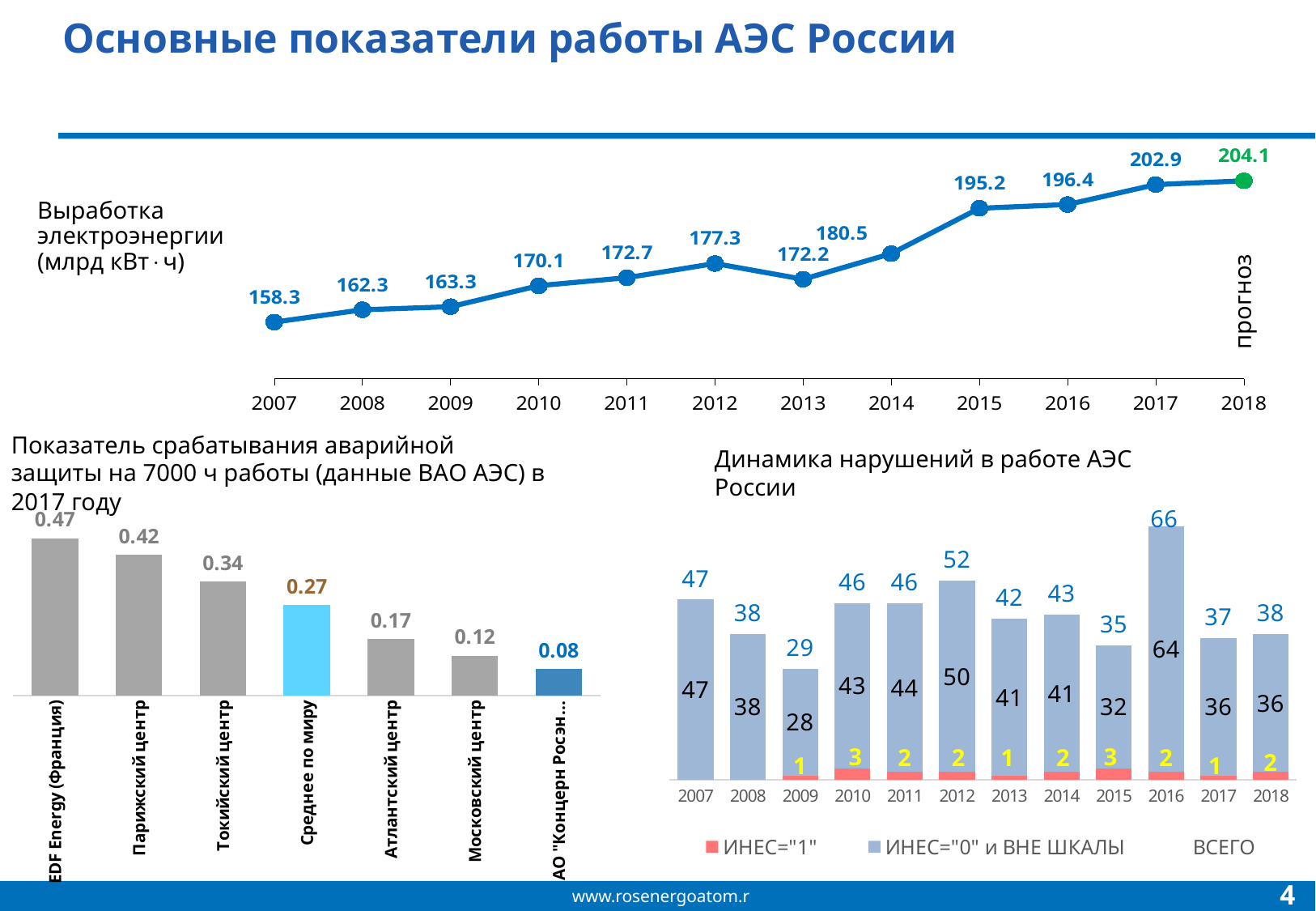
In the line chart 'Выработка электроэнергии (млрд кВт·ч)', which year has the lowest value? 2007 In the bar chart 'Показатель срабатывания аварийной защиты на 7000 ч работы', what is the value for Среднее по миру? 0.27 In the line chart 'Выработка электроэнергии (млрд кВт·ч)', what label is attached to the 2018 point? прогноз In the chart 'Динамика нарушений в работе АЭС России', what is the ИНЕС="1" value for 2010? 3 In the line chart 'Выработка электроэнергии (млрд кВт·ч)', how many years are plotted? 12 In the bar chart 'Показатель срабатывания аварийной защиты на 7000 ч работы', what is the difference between Парижский центр and Московский центр? 0.30 In the line chart 'Выработка электроэнергии (млрд кВт·ч)', what is the difference between the 2018 forecast value and the 2007 value? 45.8 In the line chart 'Выработка электроэнергии (млрд кВт·ч)', which is larger, the value for 2012 or the value for 2013? 2012 In the line chart 'Выработка электроэнергии (млрд кВт·ч)', what is the value for 2015? 195.2 In the bar chart 'Показатель срабатывания аварийной защиты на 7000 ч работы', which category has the highest value? EDF Energy (Франция) In the chart 'Динамика нарушений в работе АЭС России', what is the total (ВСЕГО) for 2016? 66 In the chart 'Динамика нарушений в работе АЭС России', how many entries does the legend list? 3